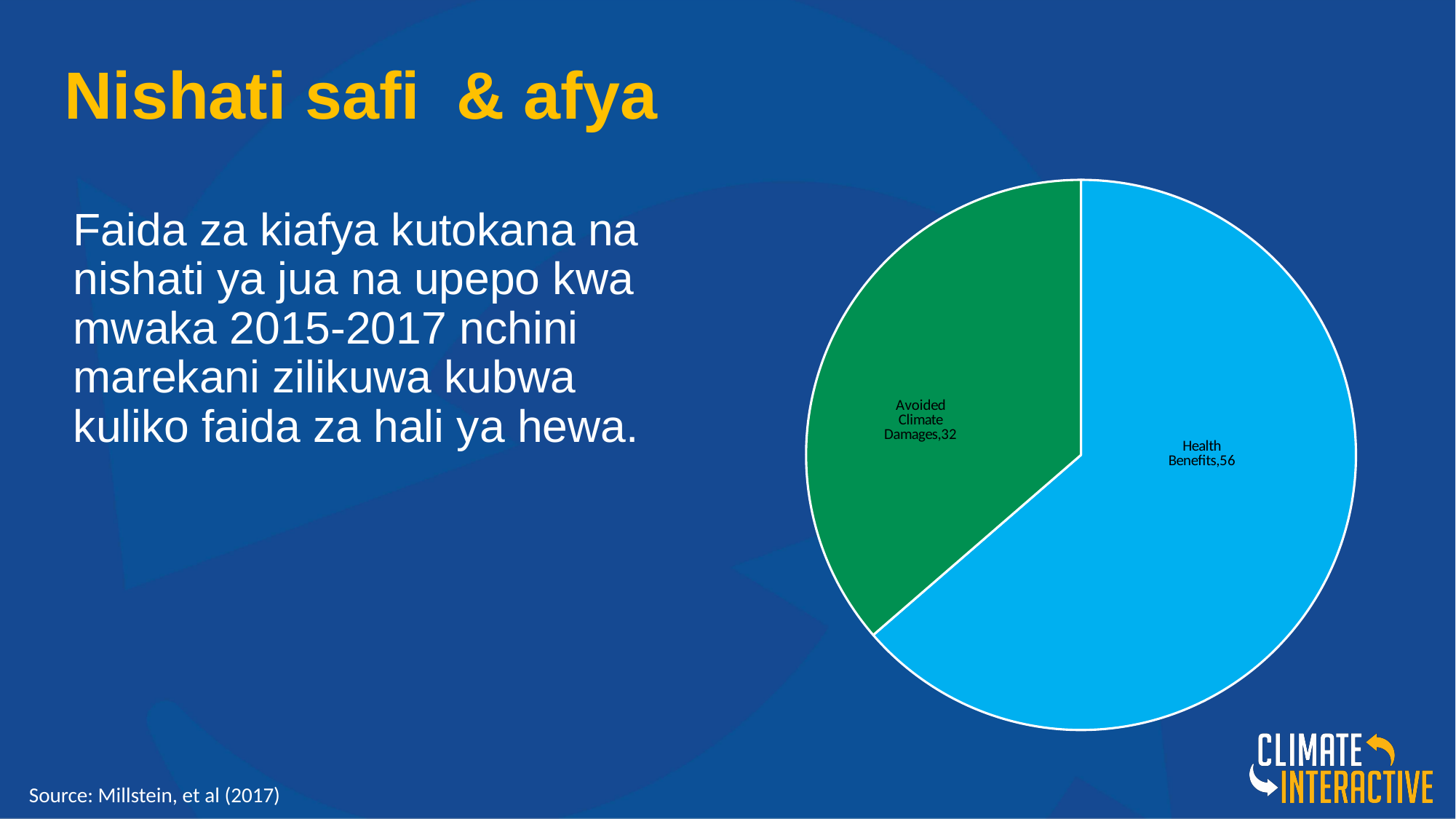
What colour is the Health Benefits slice? Light blue What is the value for Health Benefits in the pie chart? 56 How many slices does the pie chart have? 2 What kind of chart is shown on the slide? Pie chart What is the difference between the Health Benefits value and the Avoided Climate Damages value? 24 Which is larger, Health Benefits or Avoided Climate Damages? Health Benefits What colour is the Avoided Climate Damages slice? Green Which slice of the pie chart is the largest? Health Benefits Which slice of the pie chart is the smallest? Avoided Climate Damages What is the value for Avoided Climate Damages in the pie chart? 32 What is the total of the two values shown in the pie chart? 88 What share of the pie does the Health Benefits slice represent? 64%